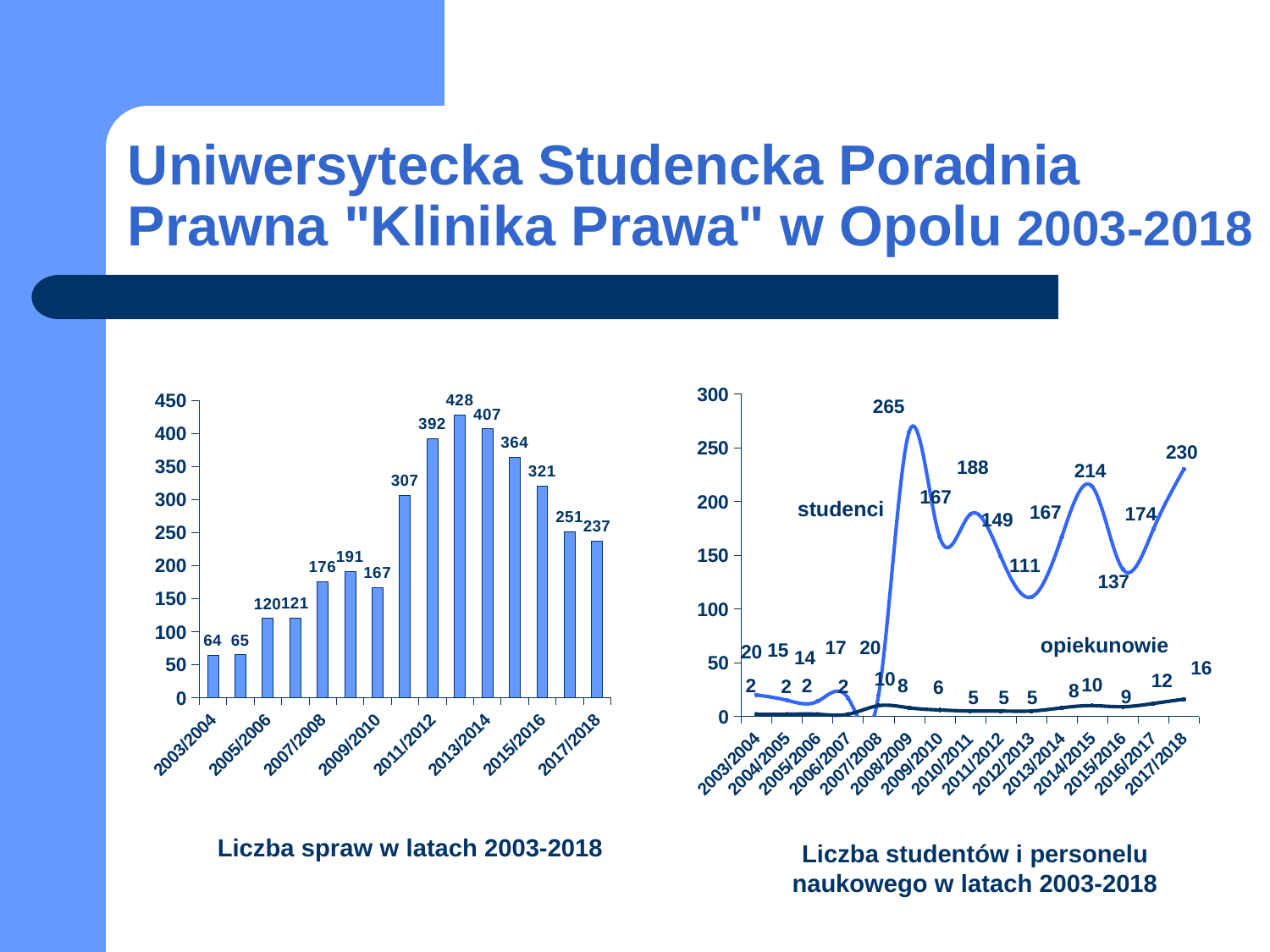
What kind of chart is the right chart, 'Liczba studentów i personelu naukowego w latach 2003-2018'? line chart In the right chart 'Liczba studentów i personelu naukowego w latach 2003-2018', what is the value of 'opiekunowie' for 2017/2018? 16 How many series are plotted in the right chart 'Liczba studentów i personelu naukowego w latach 2003-2018'? 2 In the right chart 'Liczba studentów i personelu naukowego w latach 2003-2018', in which year does the 'studenci' series reach its highest value? 2008/2009 In the right chart 'Liczba studentów i personelu naukowego w latach 2003-2018', is the 'studenci' value higher in 2014/2015 or in 2016/2017? 2014/2015 In the left chart 'Liczba spraw w latach 2003-2018', what is the value for 2011/2012? 392 How many bars are plotted in the left chart 'Liczba spraw w latach 2003-2018'? 15 In the left chart 'Liczba spraw w latach 2003-2018', which year has the highest value? 2012/2013 What kind of chart is the left chart, 'Liczba spraw w latach 2003-2018'? bar chart In the left chart 'Liczba spraw w latach 2003-2018', which year has the lowest value? 2003/2004 In the right chart 'Liczba studentów i personelu naukowego w latach 2003-2018', what is the value of 'studenci' for 2008/2009? 265 In the left chart 'Liczba spraw w latach 2003-2018', what is the difference between the values for 2012/2013 and 2017/2018? 191